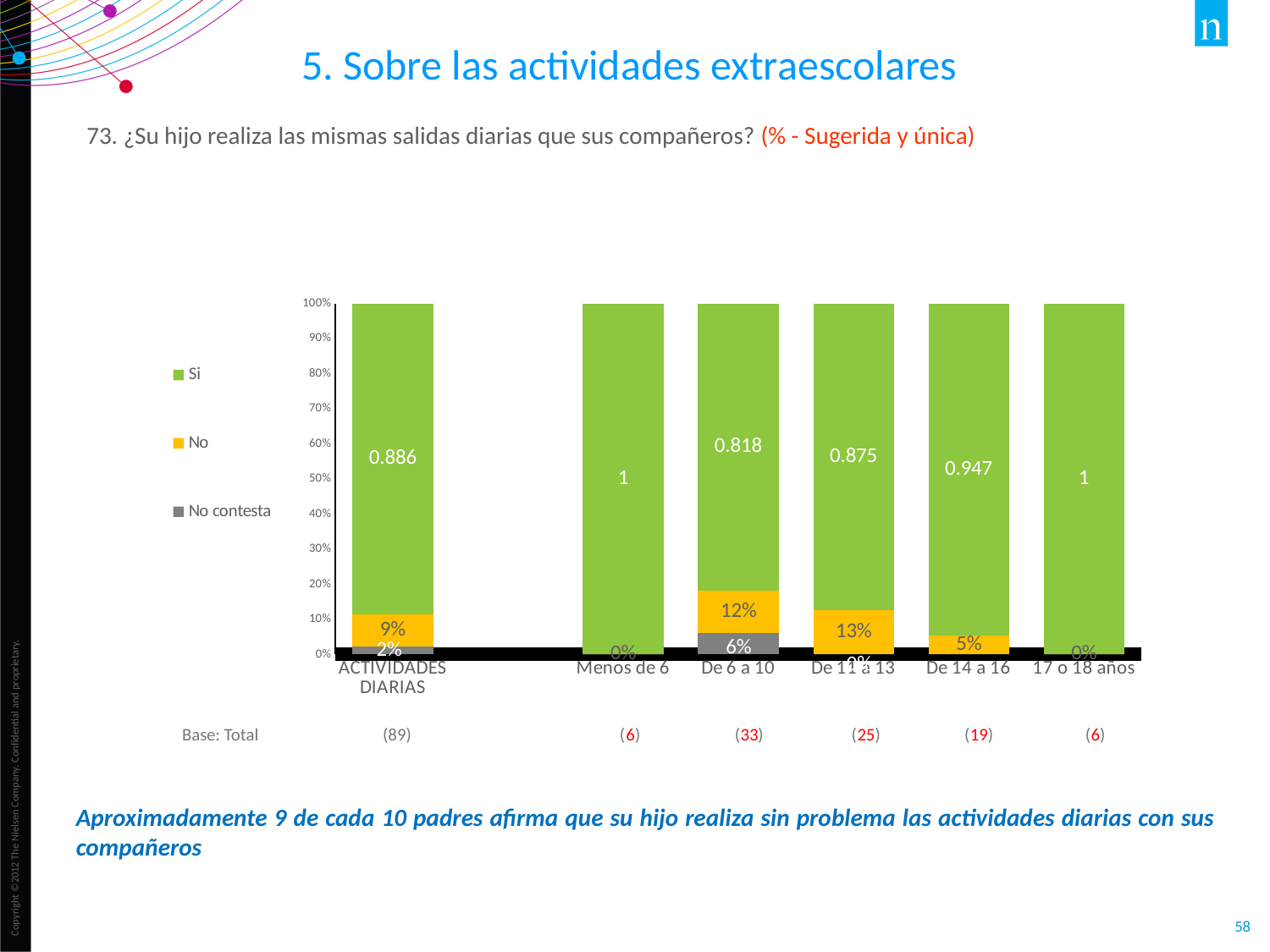
Which has a larger "No" value: ACTIVIDADES DIARIAS or De 14 a 16? ACTIVIDADES DIARIAS What percentage of the "No" series is shown for the De 6 a 10 category? 12% What is the "Si" value shown for the De 14 a 16 category? 0.947 What kind of chart is shown on the slide? Stacked bar chart What is the "No contesta" value for the De 6 a 10 category? 6% What is the "No" value for the De 11 a 13 category? 13% Which category has the lowest "Si" value? De 6 a 10 Which category has the highest "No" value? De 11 a 13 What is the difference between the "No" values for De 6 a 10 and De 14 a 16? 7 percentage points How many categories are shown on the x axis of the chart? 6 What is the value of the "Si" series for the ACTIVIDADES DIARIAS bar? 0.886 How many series does the legend list? 3